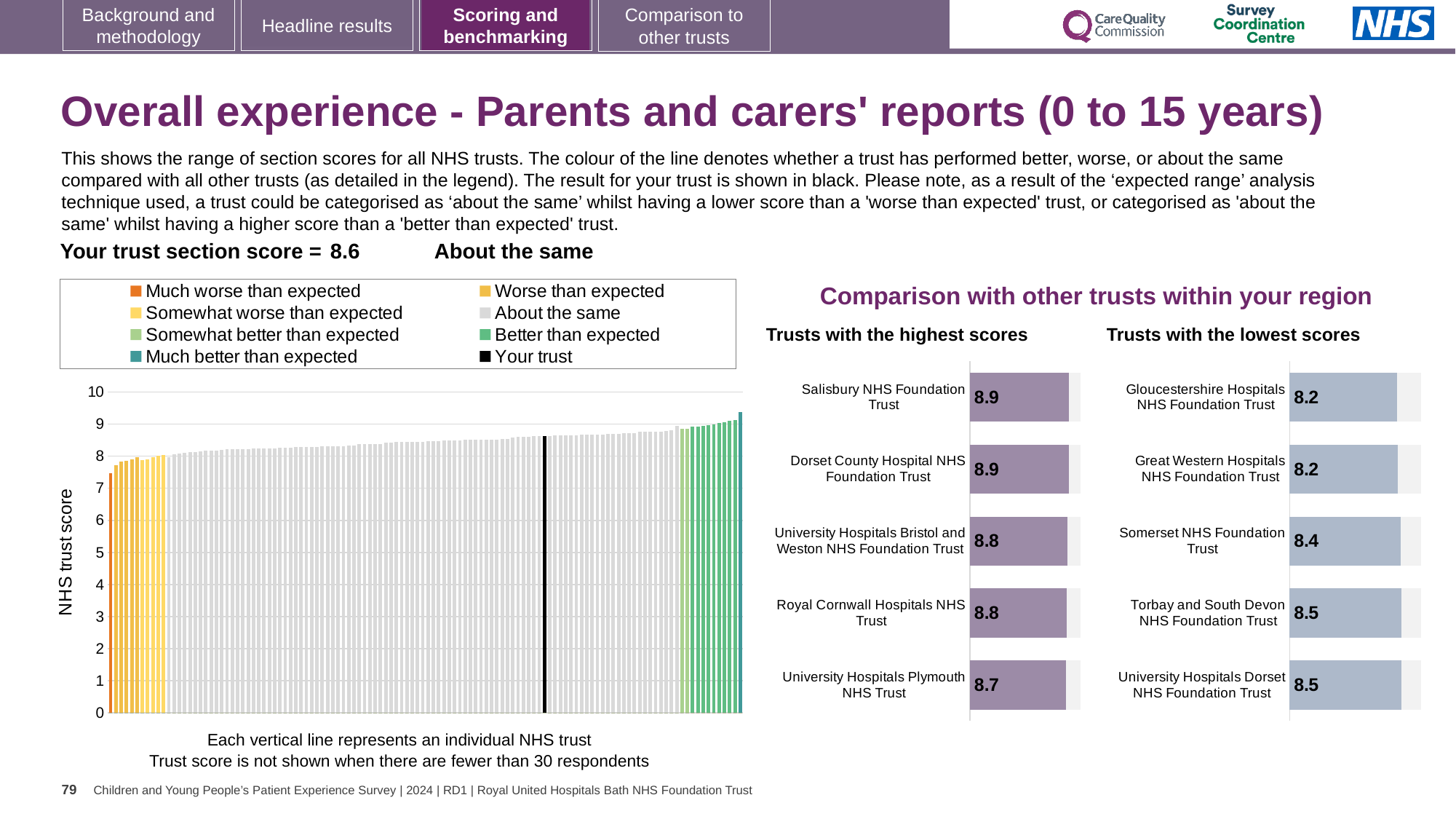
In the 'Trusts with the lowest scores' chart, what is the score for Gloucestershire Hospitals NHS Foundation Trust? 8.2 In the 'Trusts with the highest scores' chart, what is the score for University Hospitals Plymouth NHS Trust? 8.7 How many trusts are shown in the 'Trusts with the lowest scores' chart? 5 How many entries does the legend above the main NHS trust score chart list? 8 In the 'Trusts with the lowest scores' chart, which has the higher score: Somerset NHS Foundation Trust or Torbay and South Devon NHS Foundation Trust? Torbay and South Devon NHS Foundation Trust In the 'Trusts with the lowest scores' chart, what is the score for Somerset NHS Foundation Trust? 8.4 In the main NHS trust score chart on the left, is the value for the black 'Your trust' bar greater or less than 8? greater In the 'Trusts with the highest scores' chart, what is the difference between the scores of Salisbury NHS Foundation Trust and University Hospitals Plymouth NHS Trust? 0.2 What kind of chart is the 'Trusts with the highest scores' chart? bar chart In the main NHS trust score chart on the left, do the trust scores rise or fall from left to right? rise In the 'Trusts with the highest scores' chart, what is the score for Salisbury NHS Foundation Trust? 8.9 In the 'Trusts with the highest scores' chart, which trust has the lowest score? University Hospitals Plymouth NHS Trust